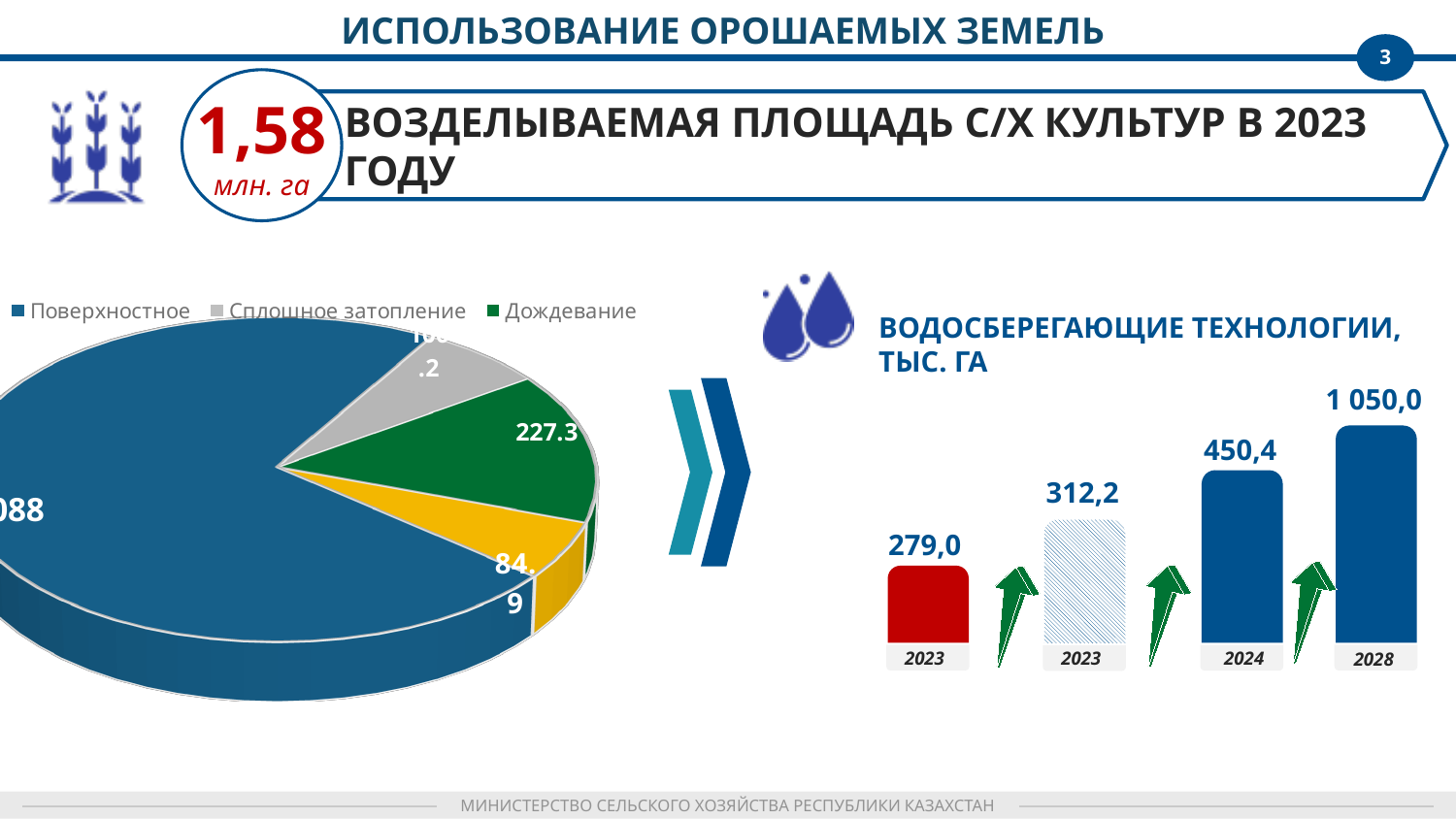
In the pie chart on the left, what value is shown for the Дождевание slice? 227.3 How many bars are shown in the chart titled ВОДОСБЕРЕГАЮЩИЕ ТЕХНОЛОГИИ, ТЫС. ГА? 4 In the chart titled ВОДОСБЕРЕГАЮЩИЕ ТЕХНОЛОГИИ, ТЫС. ГА, what is the value for 2028? 1 050,0 In the chart titled ВОДОСБЕРЕГАЮЩИЕ ТЕХНОЛОГИИ, ТЫС. ГА, what is the difference between the values for 2028 and 2024? 599,6 In the chart titled ВОДОСБЕРЕГАЮЩИЕ ТЕХНОЛОГИИ, ТЫС. ГА, what is the value of the hatched bar? 312,2 In the chart titled ВОДОСБЕРЕГАЮЩИЕ ТЕХНОЛОГИИ, ТЫС. ГА, what is the value for 2024? 450,4 In the chart titled ВОДОСБЕРЕГАЮЩИЕ ТЕХНОЛОГИИ, ТЫС. ГА, what is the value of the first (red) bar? 279,0 In the chart titled ВОДОСБЕРЕГАЮЩИЕ ТЕХНОЛОГИИ, ТЫС. ГА, which year has the highest value? 2028 In the chart titled ВОДОСБЕРЕГАЮЩИЕ ТЕХНОЛОГИИ, ТЫС. ГА, do the values rise or fall from left to right? Rise What kind of chart is the chart on the left of the slide? Pie chart In the pie chart on the left, which category has the largest slice? Поверхностное How many entries does the legend of the pie chart on the left list? 3